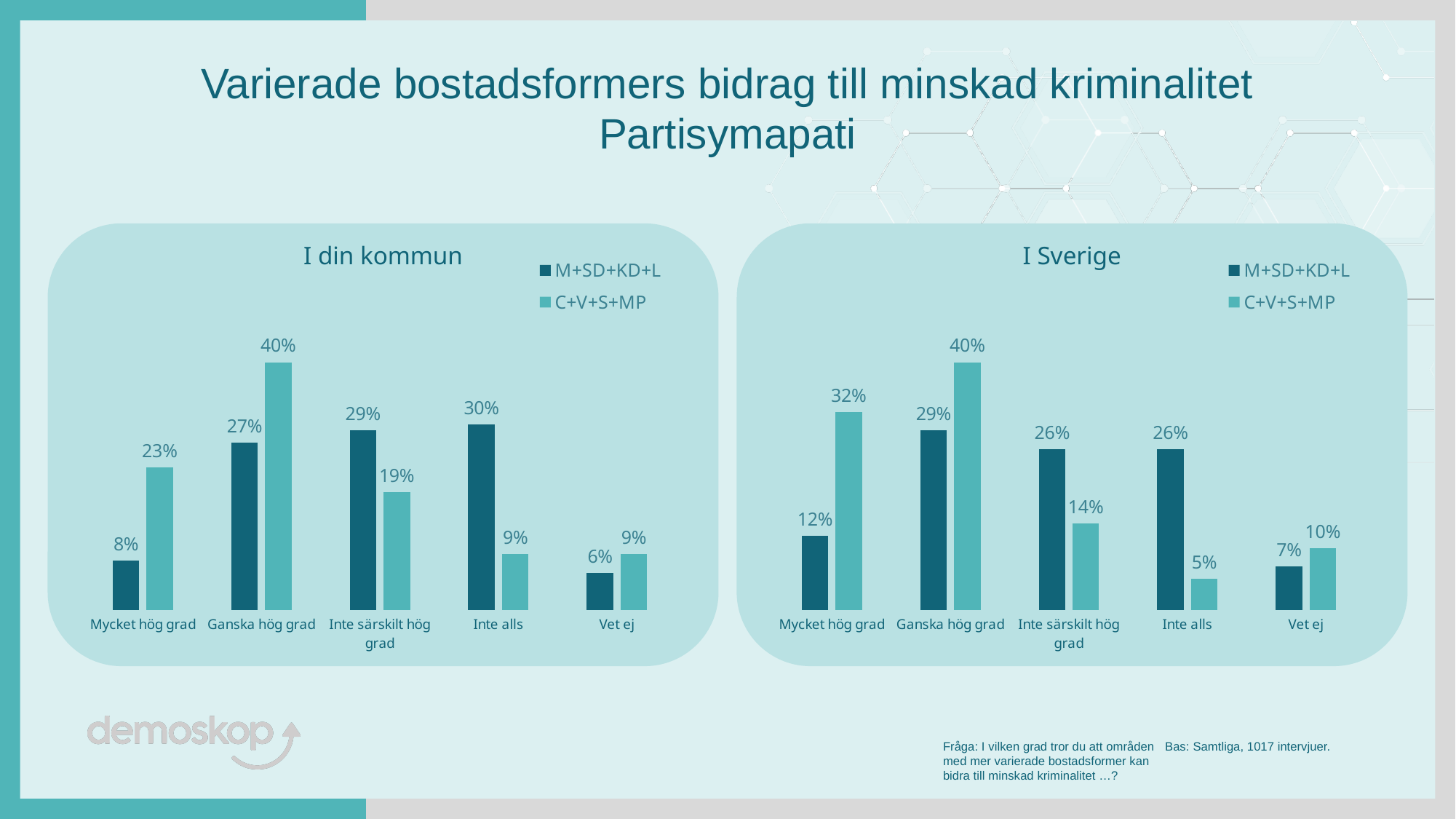
In the 'I din kommun' chart, which category has the highest value for M+SD+KD+L? Inte alls How many series does the legend of the 'I Sverige' chart list? 2 What kind of chart is the 'I din kommun' chart? Bar chart In the 'I din kommun' chart, what is the difference between the C+V+S+MP and M+SD+KD+L values in the 'Mycket hög grad' category? 15 percentage points In the 'I Sverige' chart, which category has the lowest value for C+V+S+MP? Inte alls In the 'I Sverige' chart, what is the value for C+V+S+MP in the 'Mycket hög grad' category? 32% In the 'I Sverige' chart, what is the difference between the M+SD+KD+L and C+V+S+MP values in the 'Inte alls' category? 21 percentage points In the 'I Sverige' chart, what is the value for M+SD+KD+L in the 'Vet ej' category? 7% In the 'I Sverige' chart, which series has the larger value in the 'Inte särskilt hög grad' category? M+SD+KD+L How many categories are shown on the x axis of the 'I din kommun' chart? 5 In the 'I din kommun' chart, what is the value for C+V+S+MP in the 'Ganska hög grad' category? 40% In the 'I din kommun' chart, what is the value for M+SD+KD+L in the 'Inte alls' category? 30%